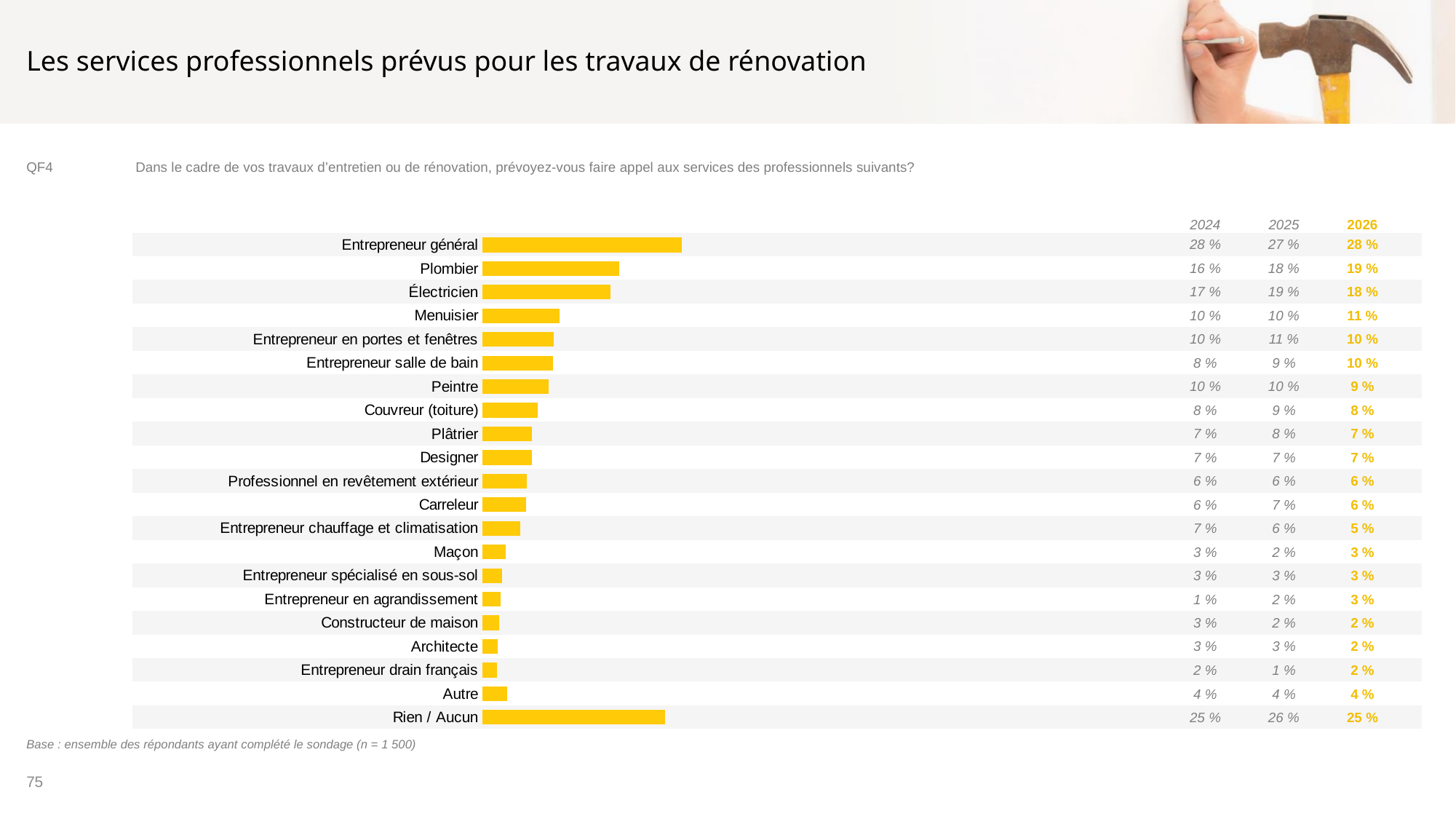
Which has a larger 2026 value, Menuisier or Peintre? Menuisier What is the 2026 value for Plombier? 19 % What is the difference between the 2026 values for Entrepreneur général and Rien / Aucun? 3 % What is the 2026 value for Entrepreneur général? 28 % What kind of chart is shown on the slide? Bar chart What is the 2026 value for Rien / Aucun? 25 % What is the 2025 value for Entrepreneur drain français? 1 % Which category has the longest bar (highest 2026 value)? Entrepreneur général How many categories are shown in the chart? 21 Which year's values are shown in bold yellow in the table? 2026 What is the difference between the 2026 values for Plombier and Électricien? 1 % What was the 2024 value for Électricien? 17 %